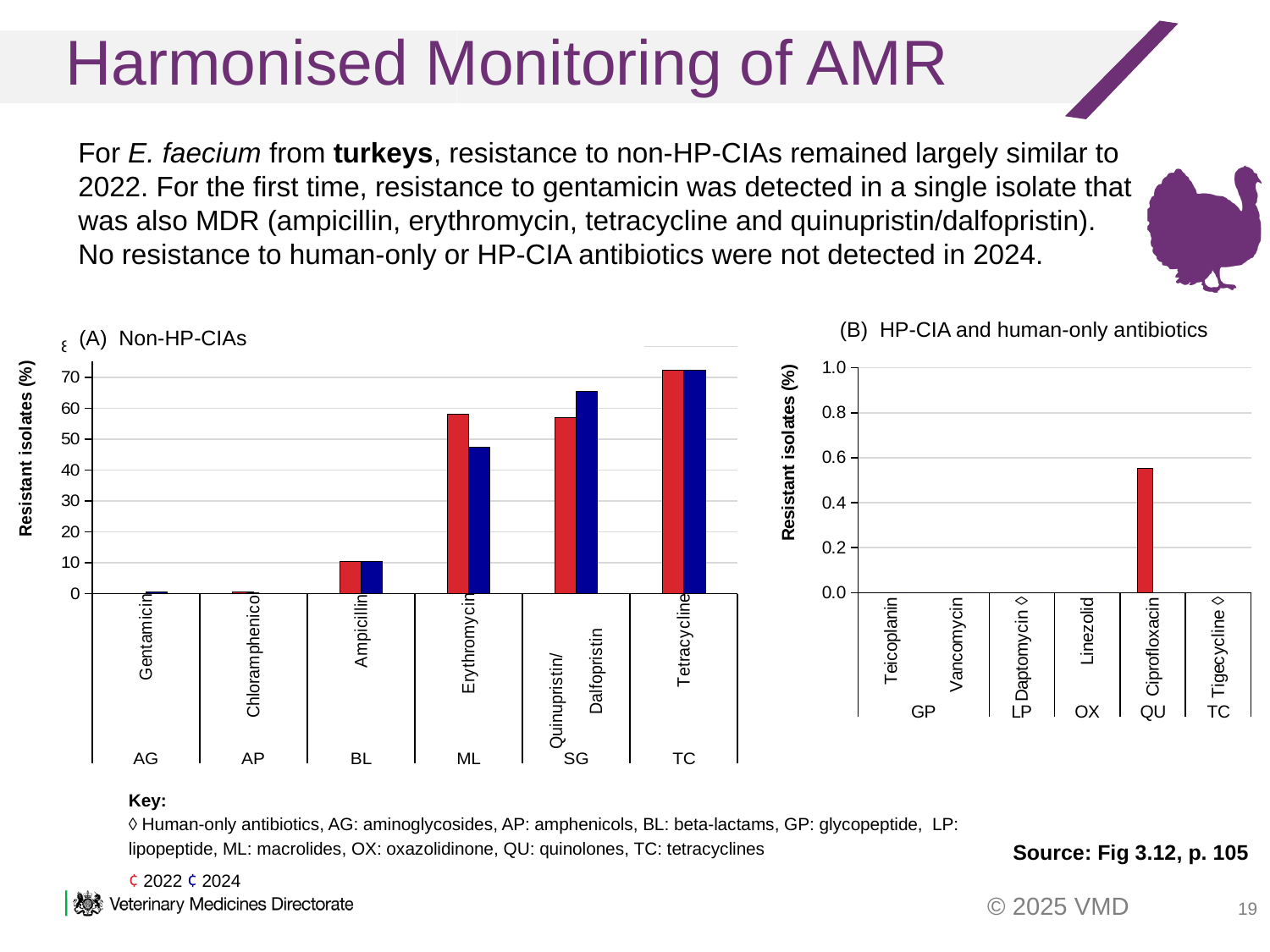
How many series does the legend list for the charts on this slide? 2 In chart (A) Non-HP-CIAs, is the value for Ampicillin greater or less than 20? less In chart (A) Non-HP-CIAs, which year has the larger value for Quinupristin/Dalfopristin, 2022 or 2024? 2024 In chart (A) Non-HP-CIAs, which antibiotic has the highest percentage of resistant isolates? Tetracycline What kind of chart is chart (A) Non-HP-CIAs? Bar chart What is the y-axis label of chart (B) HP-CIA and human-only antibiotics? Resistant isolates (%) In chart (A) Non-HP-CIAs, is the 2022 value for Erythromycin greater or less than 50? greater In chart (A) Non-HP-CIAs, is the 2024 value for Erythromycin greater or less than 50? less In chart (B) HP-CIA and human-only antibiotics, which antibiotic is the only one with a visible bar? Ciprofloxacin How many antibiotic categories are shown on the x axis of chart (A) Non-HP-CIAs? 6 In chart (A) Non-HP-CIAs, which year has the larger value for Erythromycin, 2022 or 2024? 2022